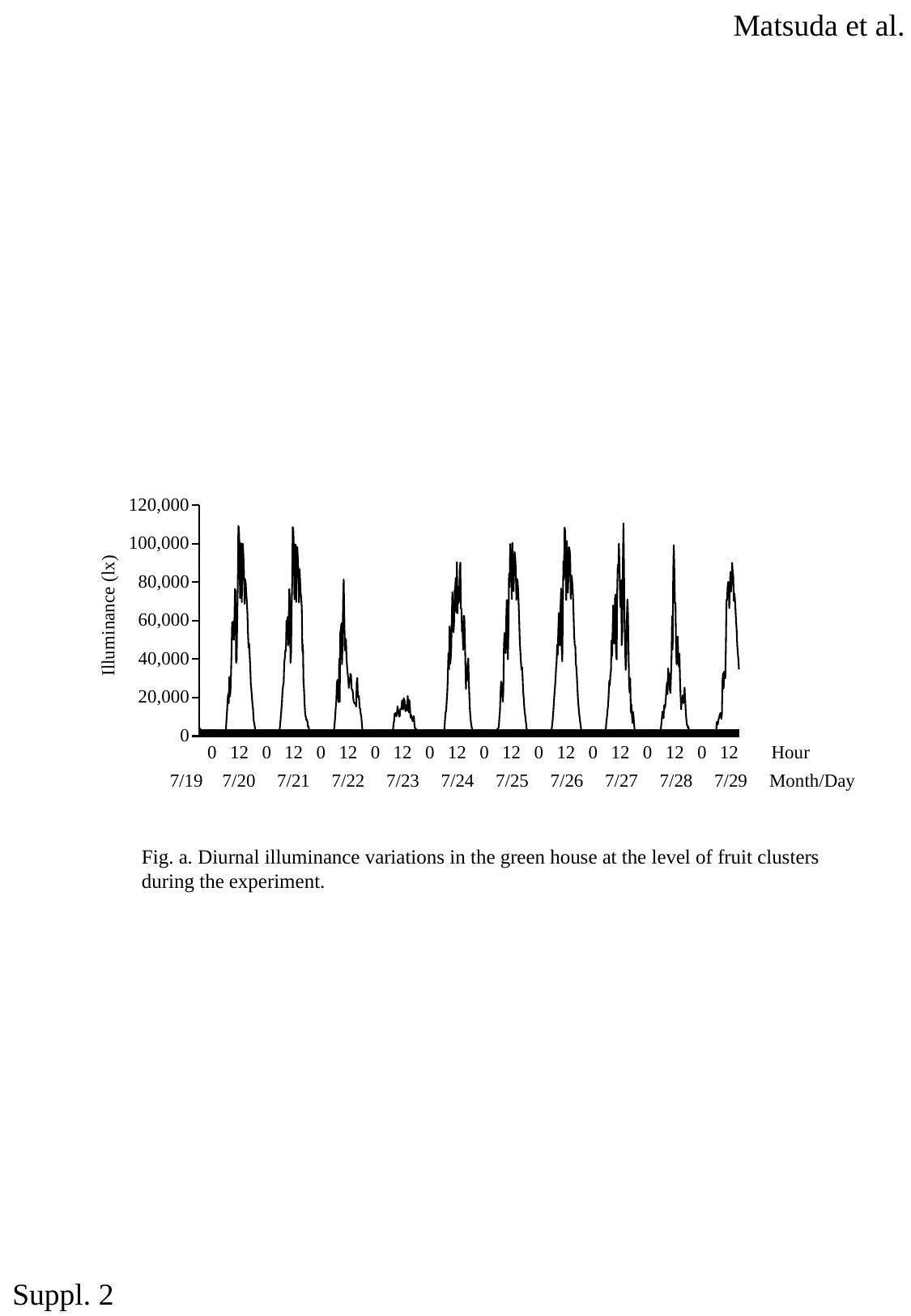
Which day has the higher peak illuminance, 7/22 or 7/23? 7/22 Is the peak illuminance on 7/23 greater or less than 40,000? less Is the peak illuminance on 7/20 greater or less than 100,000? greater Is the peak illuminance on 7/22 greater or less than 60,000? greater Which day has the higher peak illuminance, 7/20 or 7/22? 7/20 How many Month/Day labels are shown along the x axis of the chart? 11 What kind of chart is shown on the slide? line chart What is the label of the y axis of the chart? Illuminance (lx) On which day is the peak illuminance the lowest? 7/23 What is the highest value shown on the y axis of the chart? 120,000